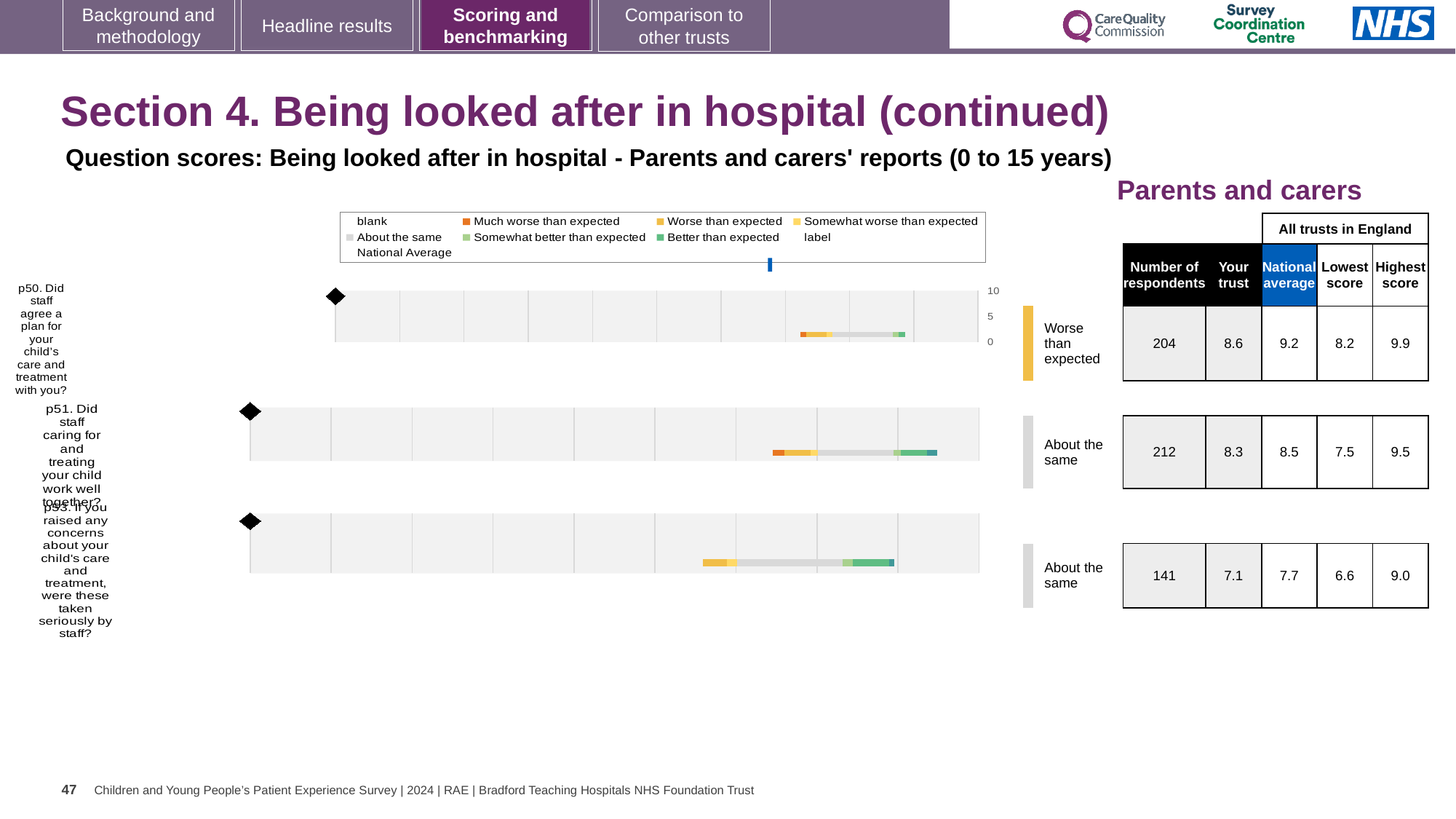
Which of the three questions has the highest 'Your trust' score? p50 What is the difference between the national average and the 'Your trust' score for question p50? 0.6 What benchmark category is shown for question p50? Worse than expected How many survey questions are plotted on this slide? 3 What is the 'Your trust' score for question p51 (Did staff caring for and treating your child work well together?)? 8.3 Which of the three questions has the lowest number of respondents? p53 For question p51, is the 'Your trust' score higher or lower than the national average? lower What is the national average score for question p53 (If you raised any concerns about your child's care and treatment, were these taken seriously by staff?)? 7.7 What is the lowest score among all trusts in England for question p53? 6.6 What kind of chart is used to show the question scores on this slide? bar chart What is the highest score among all trusts in England for question p50? 9.9 How many respondents are shown for question p50 (Did staff agree a plan for your child's care and treatment with you?)? 204